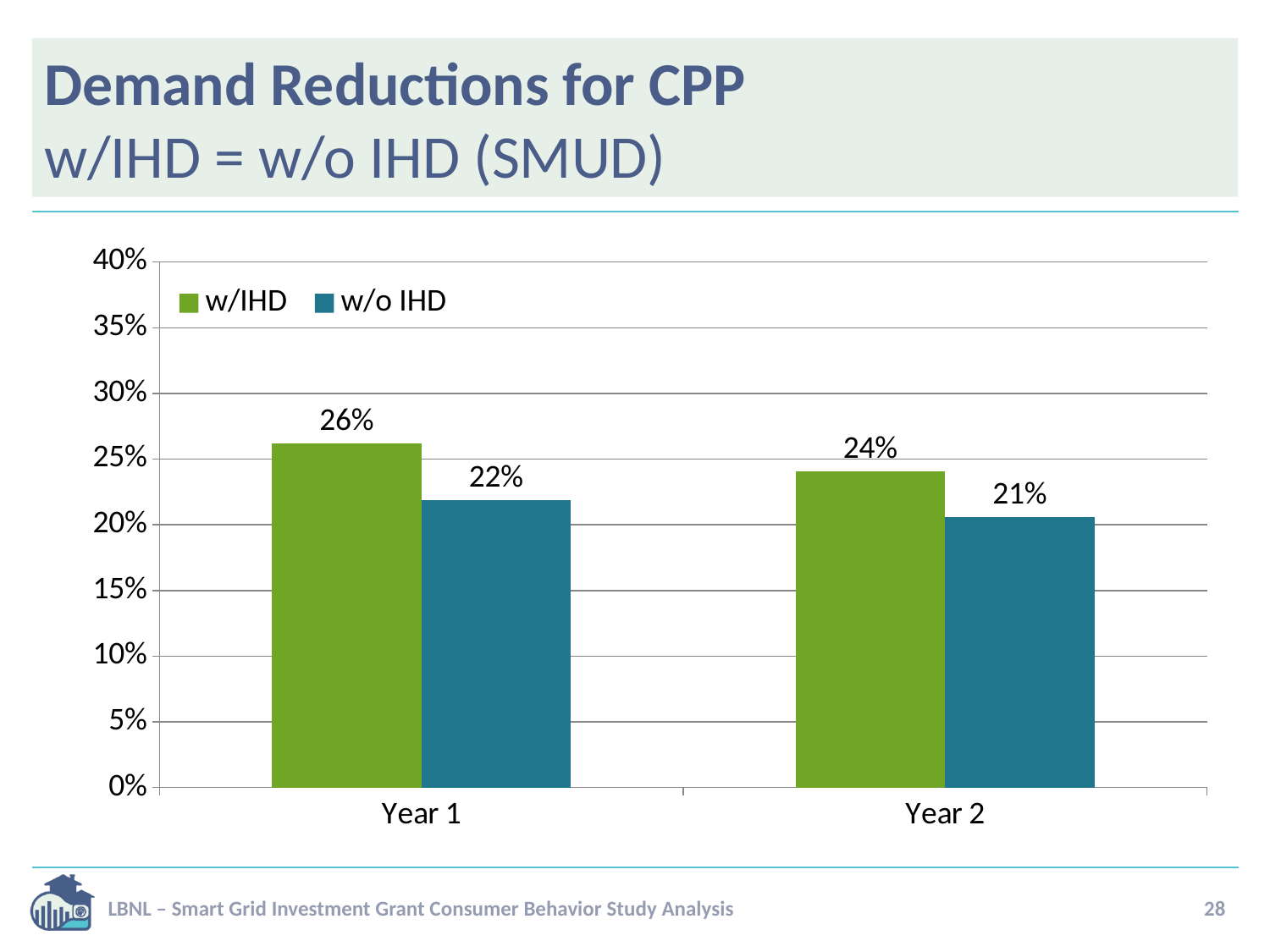
What is the value for w/IHD in Year 1? 26% Which bar has the lowest value on the chart? w/o IHD in Year 2 Which is larger: w/IHD in Year 2 or w/o IHD in Year 1? w/IHD in Year 2 What kind of chart is shown on the slide? bar chart How many series does the legend list? 2 What is the value for w/o IHD in Year 2? 21% What is the value for w/IHD in Year 2? 24% Is the value for w/IHD in Year 1 greater or less than 25%? greater Which series has the highest value in Year 1? w/IHD How many categories are shown on the x axis? 2 What is the value for w/o IHD in Year 1? 22% What is the difference between w/IHD and w/o IHD in Year 1? 4%